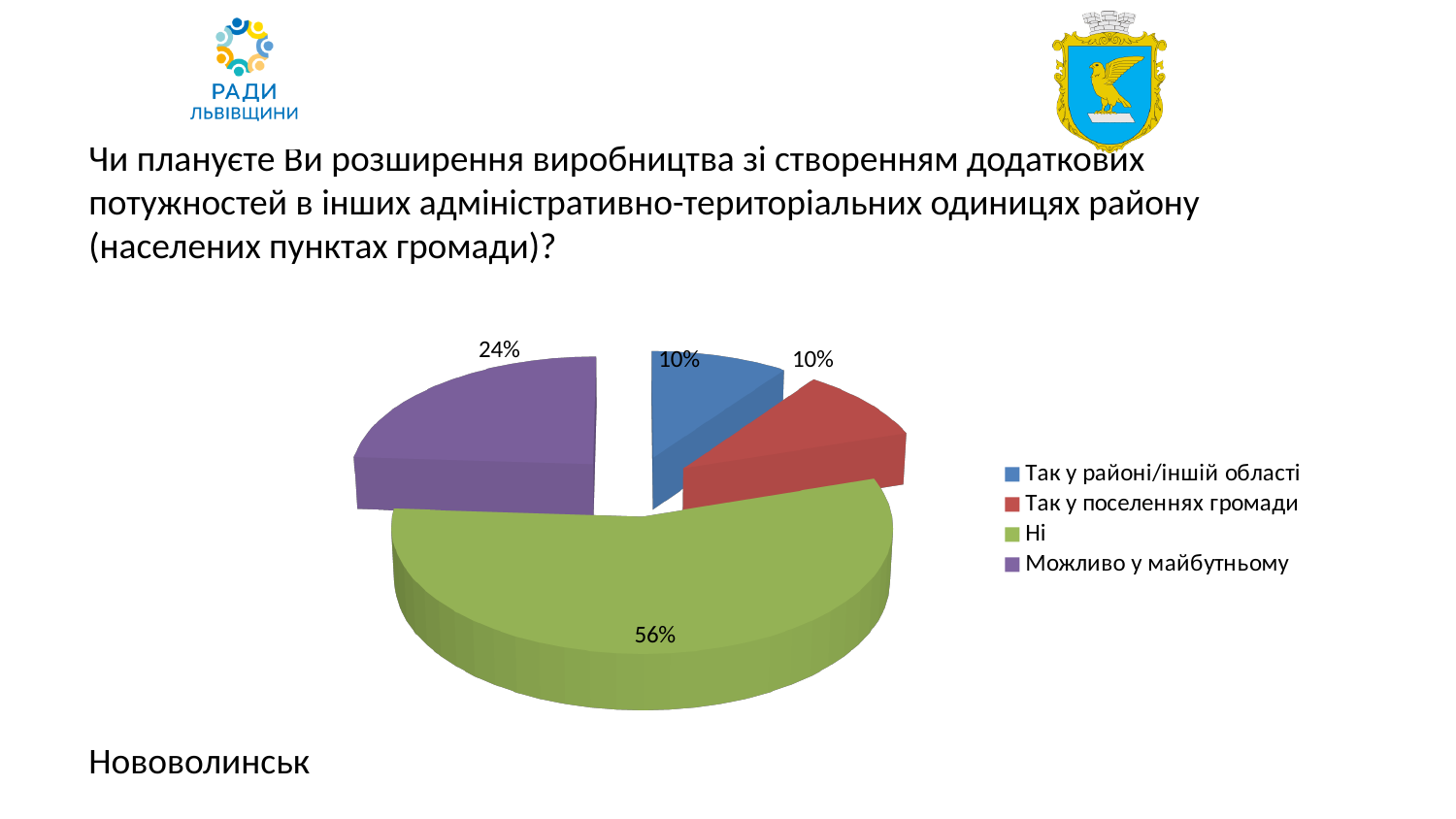
What share of the pie does "Ні" take? 56% How many entries does the legend list? 4 What is the value for "Так у поселеннях громади"? 10% Which category has the largest slice of the pie? Ні What is the value for "Так у районі/іншій області"? 10% Which city name is written below the chart? Нововолинськ Which is larger, the value for "Можливо у майбутньому" or the value for "Так у поселеннях громади"? Можливо у майбутньому What is the difference between the values for "Ні" and "Можливо у майбутньому"? 32% What share of the pie does "Можливо у майбутньому" take? 24% What colour is the slice for "Ні"? green How many categories does the pie chart show? 4 What kind of chart is shown on the slide? pie chart